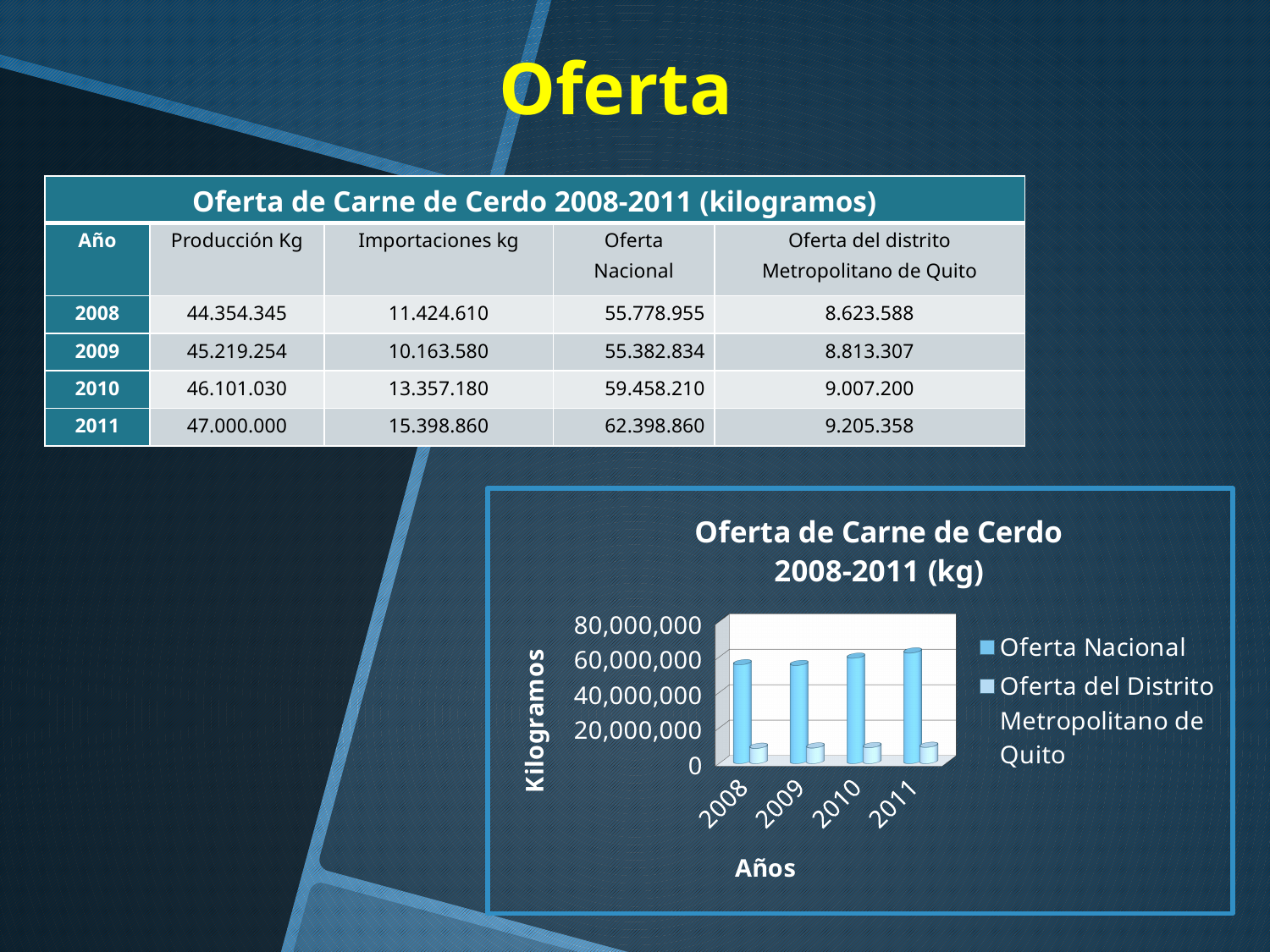
What kind of chart is shown on the slide? bar chart According to the table on the slide, what is the Oferta Nacional for 2011? 62.398.860 In the chart, is the Oferta Nacional bar for 2011 taller or shorter than the Oferta Nacional bar for 2008? taller In the chart, which series has the taller bars in every year, Oferta Nacional or Oferta del Distrito Metropolitano de Quito? Oferta Nacional According to the table on the slide, what is the Oferta del distrito Metropolitano de Quito for 2008? 8.623.588 What is the title of the chart? Oferta de Carne de Cerdo 2008-2011 (kg) How many series does the chart legend list? 2 How many years are plotted on the x axis of the chart? 4 What is the label on the chart's vertical axis? Kilogramos In the chart, is the Oferta Nacional value for 2008 greater or less than 40,000,000? greater In the chart, is the Oferta del Distrito Metropolitano de Quito value for 2010 greater or less than 20,000,000? less In the chart, is the Oferta Nacional value for 2011 greater or less than 80,000,000? less